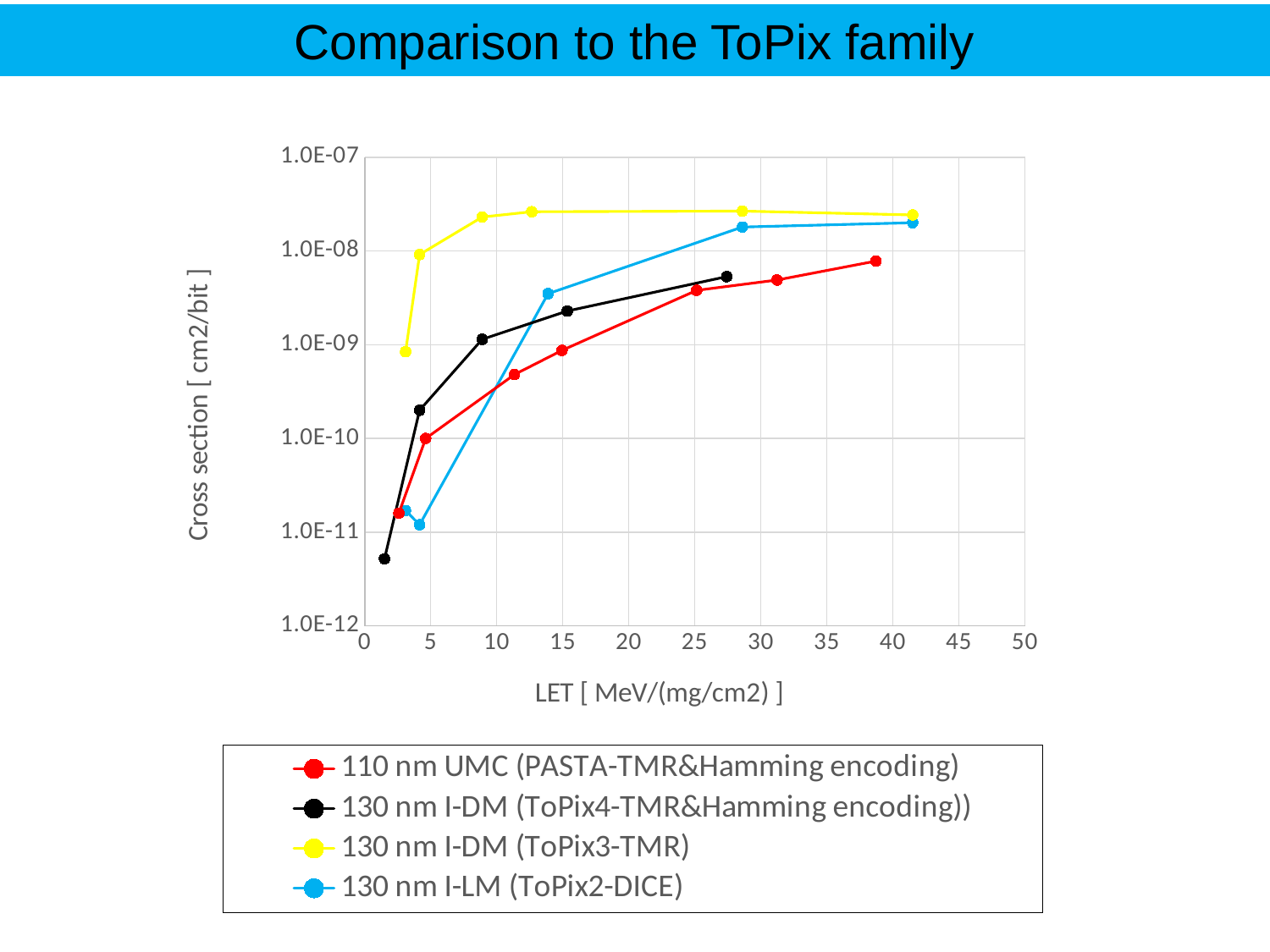
Which series has the lowest cross section point on the chart? 130 nm I-DM (ToPix4-TMR&Hamming encoding)) How many data points are plotted for the 130 nm I-DM (ToPix4-TMR&Hamming encoding)) series? 5 Is the cross section of the 130 nm I-DM (ToPix3-TMR) series at LET around 28 greater or less than 1.0E-08? greater How many series does the legend list? 4 What is the label of the y axis? Cross section [ cm2/bit ] What kind of chart is shown on the slide? line chart Is the cross section of the 110 nm UMC (PASTA-TMR&Hamming encoding) series at its highest LET point greater or less than 1.0E-08? less Which series reaches the highest cross section values on the chart? 130 nm I-DM (ToPix3-TMR) At LET around 40, which series has the larger cross section: 130 nm I-DM (ToPix3-TMR) or 110 nm UMC (PASTA-TMR&Hamming encoding)? 130 nm I-DM (ToPix3-TMR) Is the cross section of the 130 nm I-LM (ToPix2-DICE) series at LET around 14 greater or less than 1.0E-09? greater What is the title of the chart? Comparison to the ToPix family Does the cross section of the 110 nm UMC (PASTA-TMR&Hamming encoding) series rise or fall as LET increases? rise